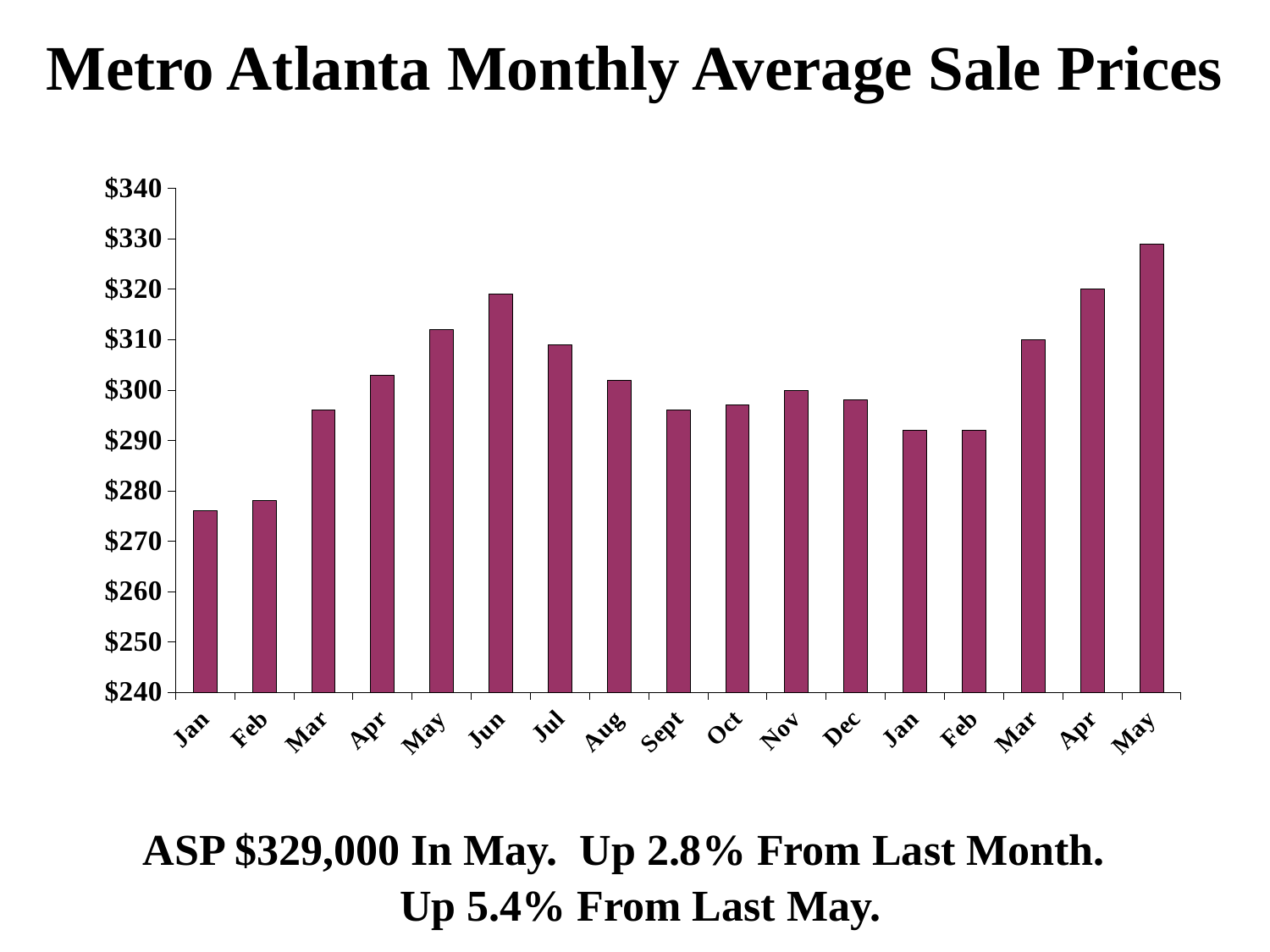
Is the value for the first Jan bar greater or less than $280? less Is the value for the second Feb bar greater or less than $300? less Is the value for Jun greater or less than $310? greater Which month has the highest average sale price in the chart? May (the last bar) How many bars are plotted in the chart? 17 Which is larger, the first May bar or the last May bar? the last May bar What is the title of the chart? Metro Atlanta Monthly Average Sale Prices Do the values rise or fall from the first Jan through Jun? rise Which is larger, the value for Jun or the value for Jul? Jun What kind of chart is shown on the slide? bar chart